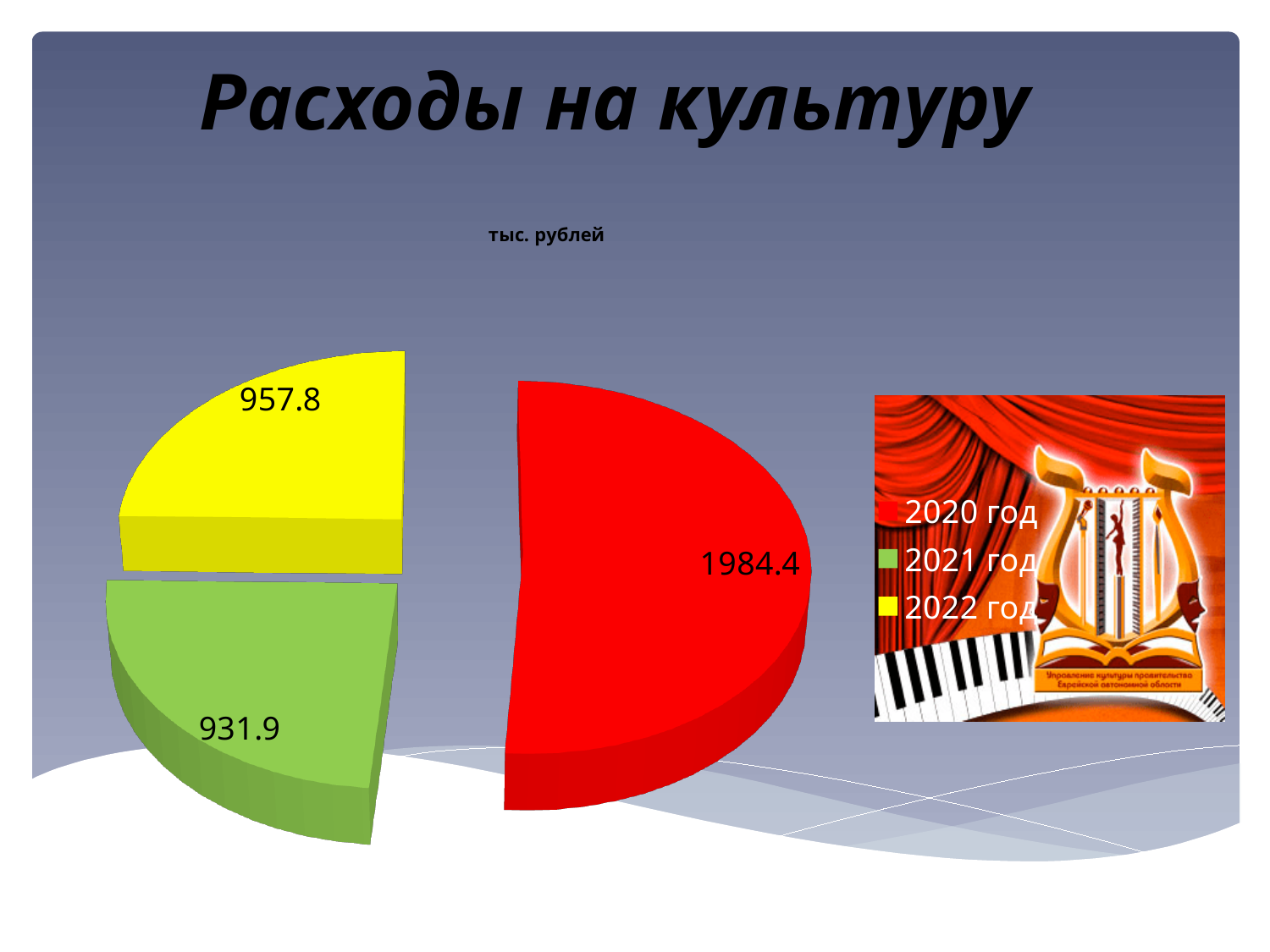
Which year has the highest expenditure on culture? 2020 год Which year has the lowest expenditure on culture? 2021 год What is the value for 2022 год? 957.8 What is the title of the slide containing the chart? Расходы на культуру What type of chart is shown on the slide? pie chart What unit is stated for the chart values? тыс. рублей What is the value for 2020 год? 1984.4 What is the difference between the values for 2022 год and 2021 год? 25.9 Which is larger, the value for 2021 год or 2022 год? 2022 год What is the value for 2021 год? 931.9 What is the difference between the values for 2020 год and 2022 год? 1026.6 How many slices does the pie chart have? 3